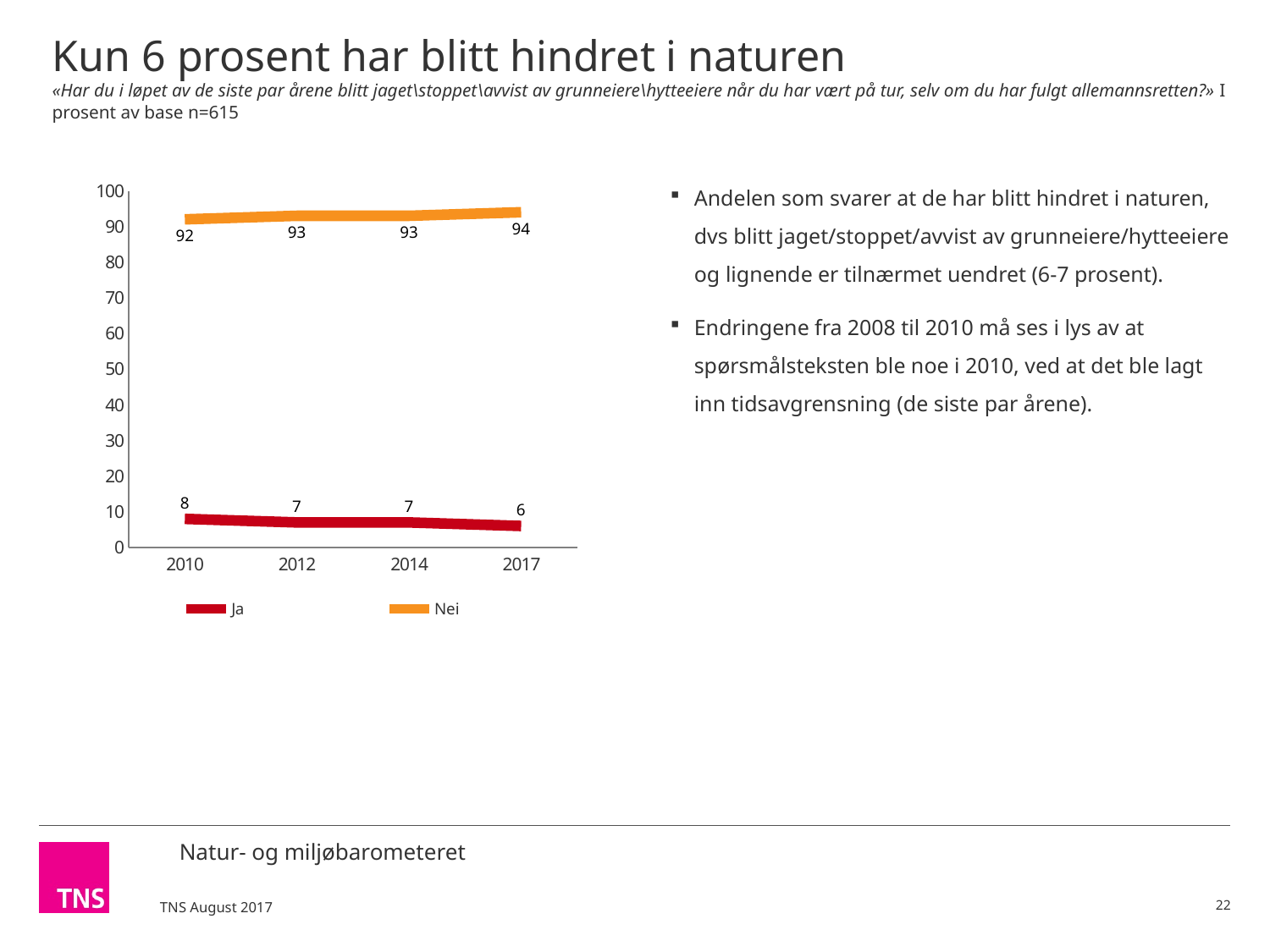
What kind of chart is shown on the slide? Line chart How many series does the legend list? 2 What is the value for "Ja" in 2010? 8 In which year is the "Ja" series highest? 2010 Does the "Ja" series rise or fall from 2010 to 2017? Fall What is the difference between the "Nei" value and the "Ja" value in 2017? 88 What is the value for "Nei" in 2017? 94 In which year is the "Nei" series lowest? 2010 How many years are shown on the x axis? 4 What is the value for "Ja" in 2014? 7 Which is larger: the "Ja" value in 2010 or the "Ja" value in 2017? 2010 What is the value for "Nei" in 2010? 92